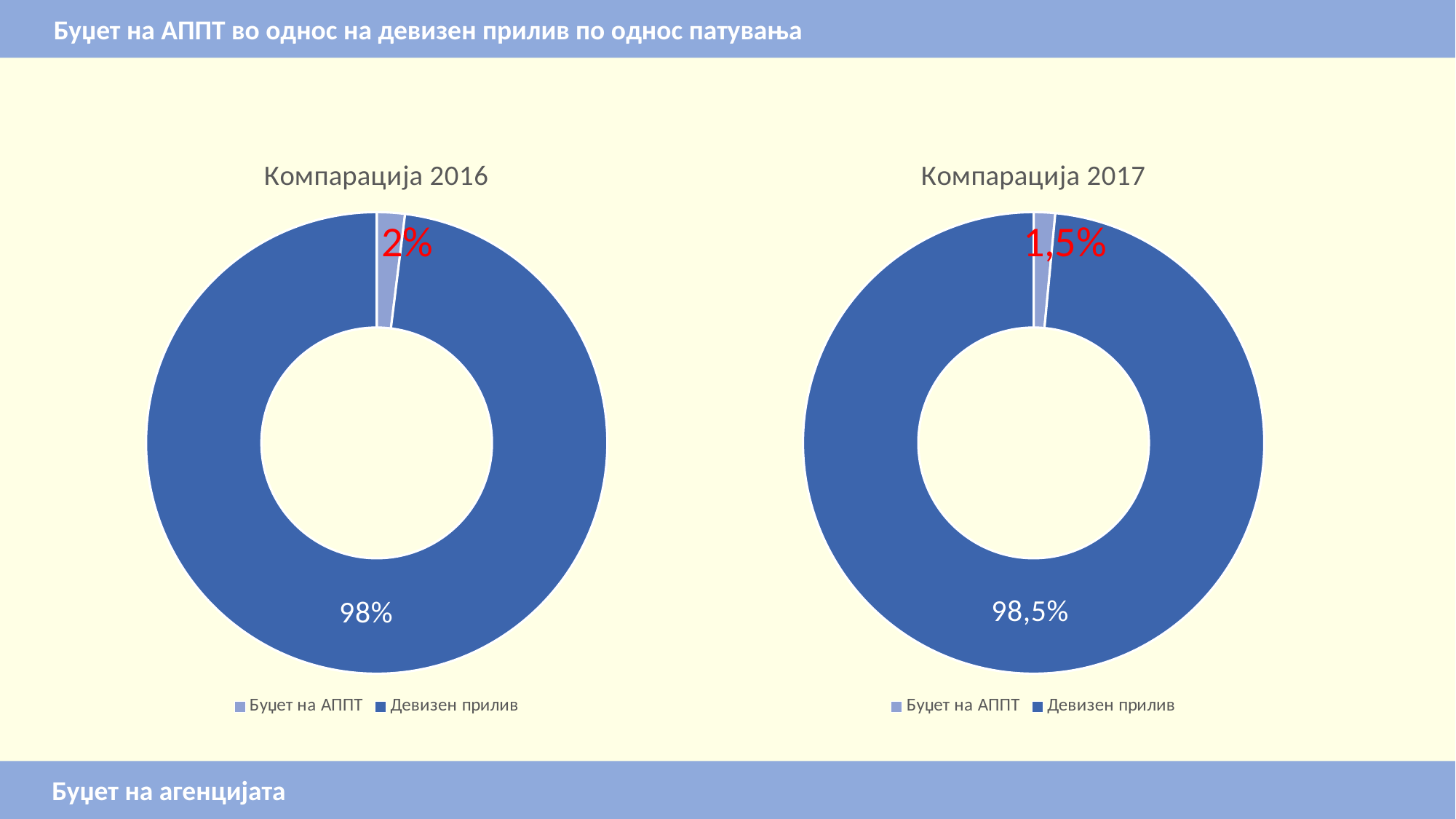
In the 'Компарација 2016' chart, what is the value for Буџет на АППТ? 2% Which is larger: Буџет на АППТ in the 'Компарација 2016' chart or Буџет на АППТ in the 'Компарација 2017' chart? Компарација 2016 In the 'Компарација 2017' chart, which category has the smallest share? Буџет на АППТ In the 'Компарација 2016' chart, what is the value for Девизен прилив? 98% How many categories does the legend of the 'Компарација 2017' chart list? 2 What type of chart is 'Компарација 2016'? Doughnut chart In the 'Компарација 2017' chart, what is the value for Буџет на АППТ? 1,5% In the 'Компарација 2017' chart, what is the difference between Девизен прилив and Буџет на АППТ? 97% In the 'Компарација 2016' chart, which category has the largest share? Девизен прилив What is the title of the chart on the right side of the slide? Компарација 2017 In the 'Компарација 2016' chart, what is the difference between Девизен прилив and Буџет на АППТ? 96% In the 'Компарација 2017' chart, what is the value for Девизен прилив? 98,5%